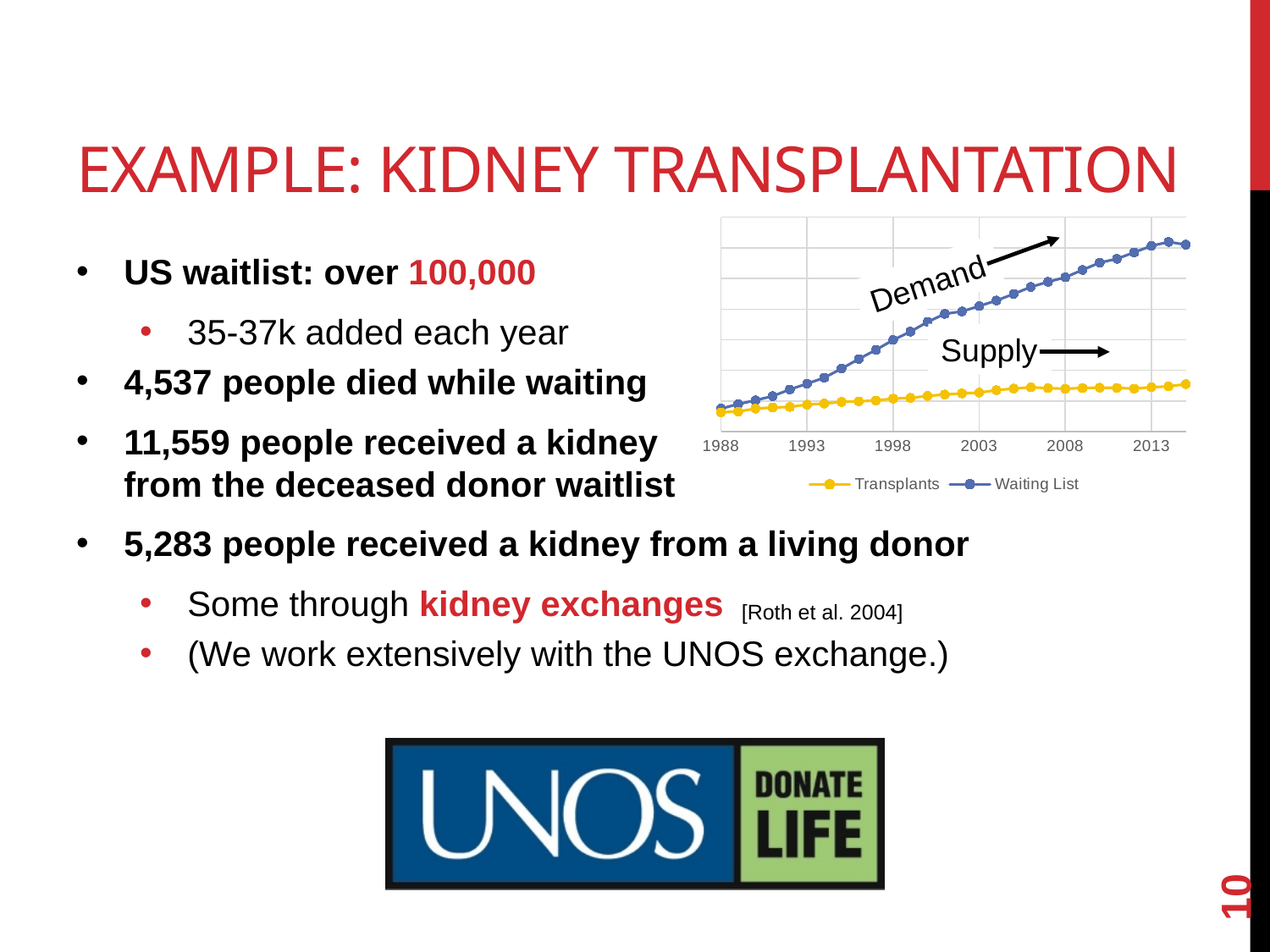
Does the Waiting List series rise or fall from 1988 to 2013? rise Which series has the lower values across the chart? Transplants How many series does the chart's legend list? 2 What is the last year label shown on the chart's x axis? 2013 Which series grows faster over the period shown, Transplants or Waiting List? Waiting List Does the Transplants series rise or fall over the years shown? rise Which series is higher in 2013, Transplants or Waiting List? Waiting List What are the two series named in the chart's legend? Transplants and Waiting List What is the first year shown on the chart's x axis? 1988 Which series is labelled 'Demand' on the chart? Waiting List What kind of chart is shown on the slide? line chart